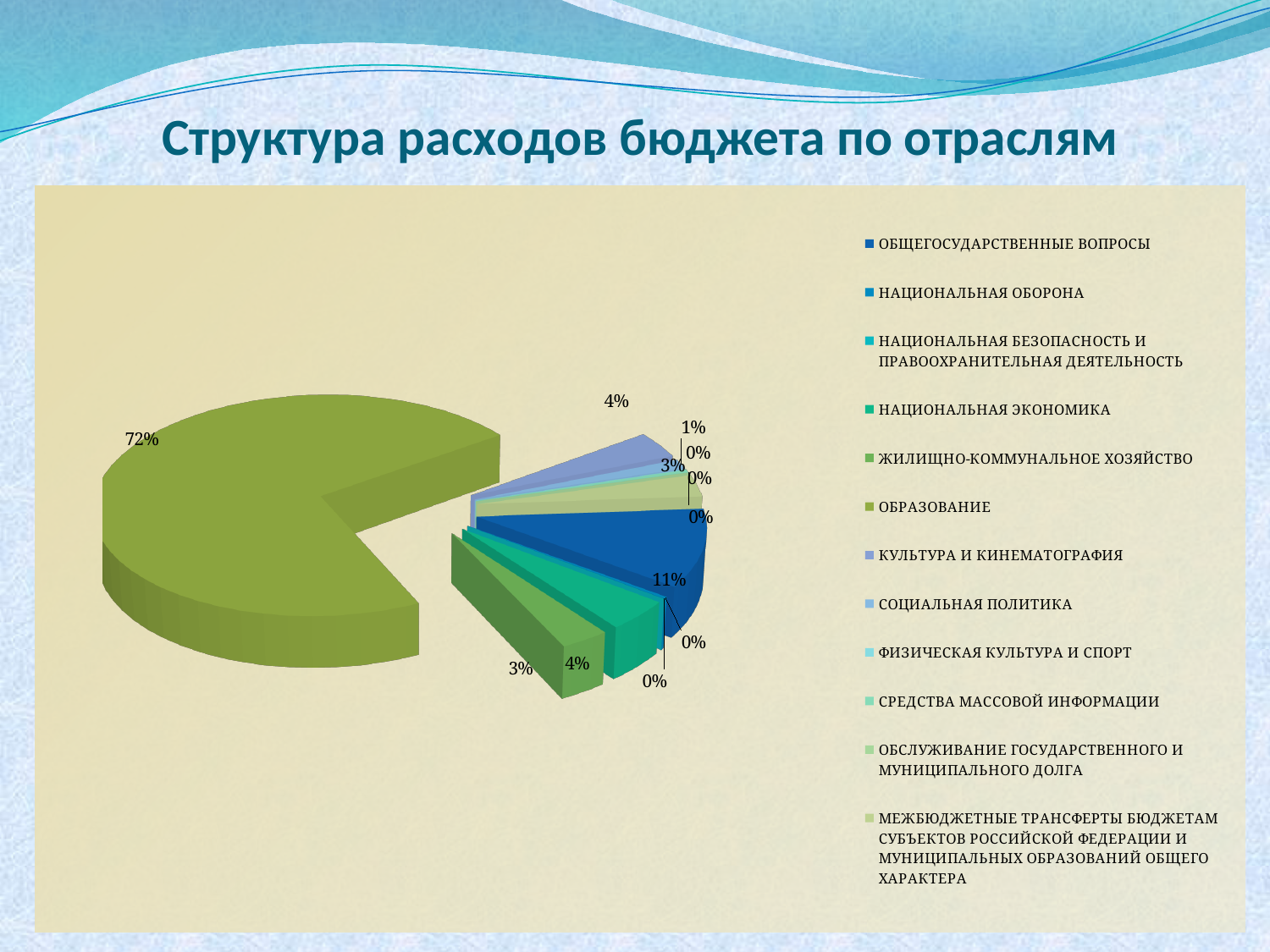
What is the difference between the shares of ОБРАЗОВАНИЕ and ОБЩЕГОСУДАРСТВЕННЫЕ ВОПРОСЫ? 61% Which category has the largest share of the pie? ОБРАЗОВАНИЕ What colour is the largest slice of the pie chart? green What share of the pie does ОБРАЗОВАНИЕ take? 72% What is the second-largest percentage label shown on the pie chart? 11% What is the title of the chart on the slide? Структура расходов бюджета по отраслям Which is larger, the share of ОБРАЗОВАНИЕ or the share of ОБЩЕГОСУДАРСТВЕННЫЕ ВОПРОСЫ? ОБРАЗОВАНИЕ What is the value shown for ОБЩЕГОСУДАРСТВЕННЫЕ ВОПРОСЫ? 11% How many categories does the legend of the pie chart list? 12 What kind of chart is shown on the slide? pie chart